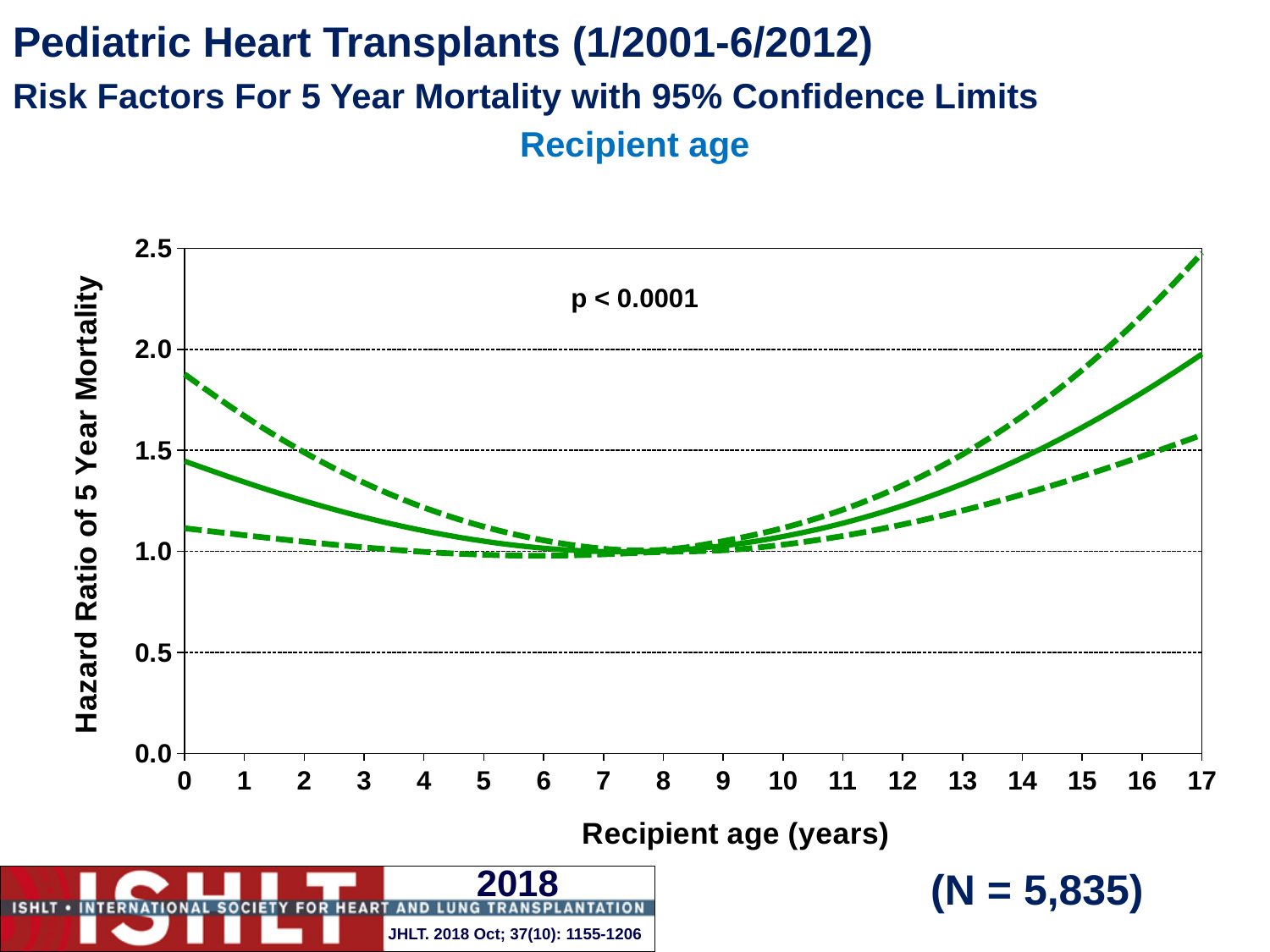
Does the hazard ratio (solid line) rise or fall as recipient age increases from 0 to 7 years? fall How many tick labels are shown on the x axis (Recipient age)? 18 How many lines are plotted on the chart? 3 Is the hazard ratio (solid line) at recipient age 15 greater or less than 1.5? greater What sample size (N) is shown on the slide? N = 5,835 What p-value is printed on the chart? p < 0.0001 Is the hazard ratio (solid line) at recipient age 12 greater or less than 1.5? less Is the upper confidence limit (upper dashed line) at recipient age 0 greater or less than 1.5? greater Does the hazard ratio (solid line) rise or fall as recipient age increases from 9 to 17 years? rise What kind of chart is shown on the slide? line chart